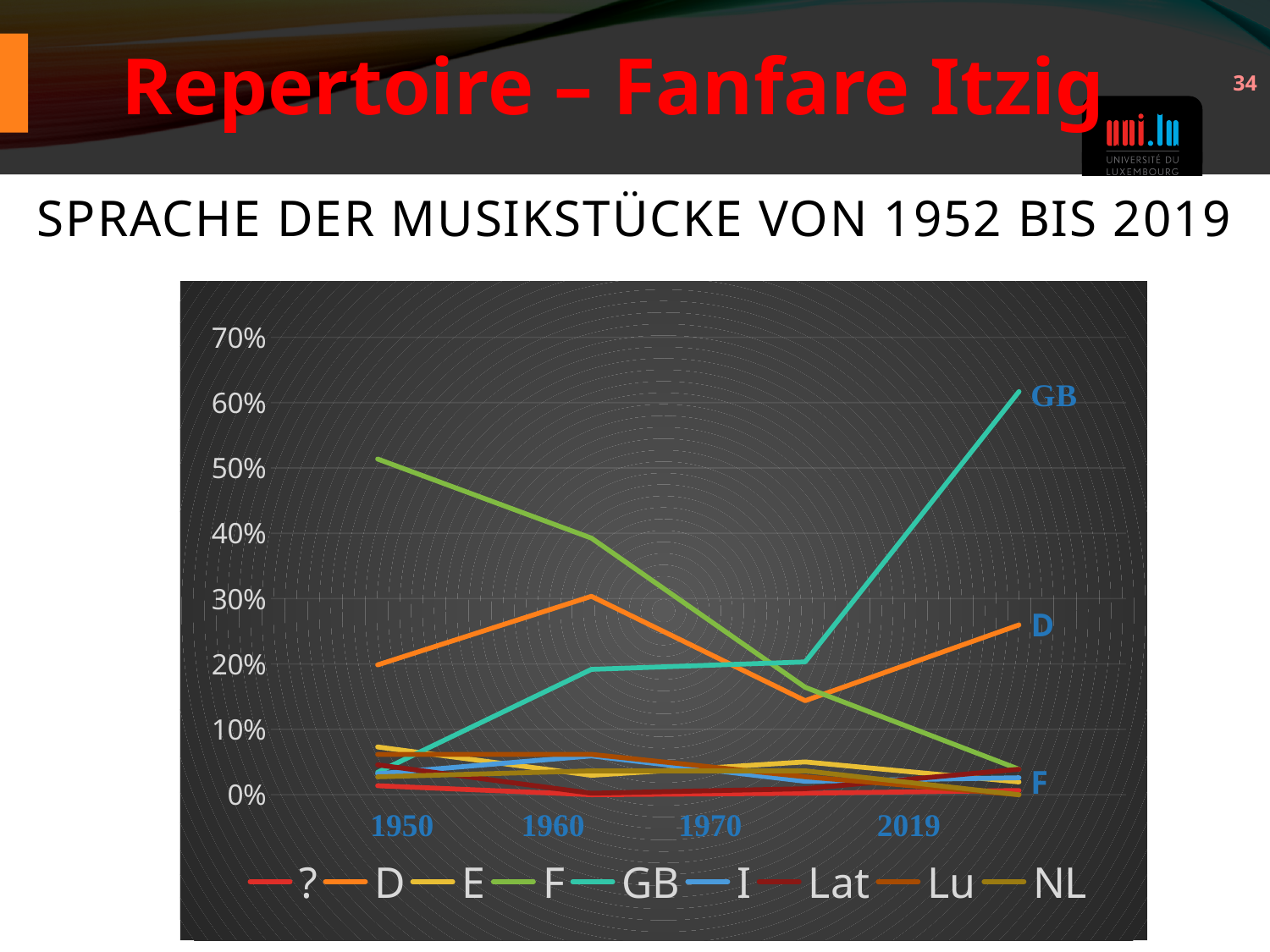
Is the value for D at 1950 greater or less than 30%? less How many year labels are shown on the x axis? 4 How many series does the legend list? 9 Is the value for GB at 2019 greater or less than 50%? greater Is the value for F at 1950 greater or less than 40%? greater Does the F series rise or fall from 1950 to 2019? fall Does the GB series rise or fall from 1950 to 2019? rise What is the subtitle above the chart? SPRACHE DER MUSIKSTÜCKE VON 1952 BIS 2019 Which series has the highest value at the last point (2019)? GB At 2019, which is larger, GB or D? GB Which series has the highest value at the first point (1950)? F What kind of chart is shown on the slide? line chart